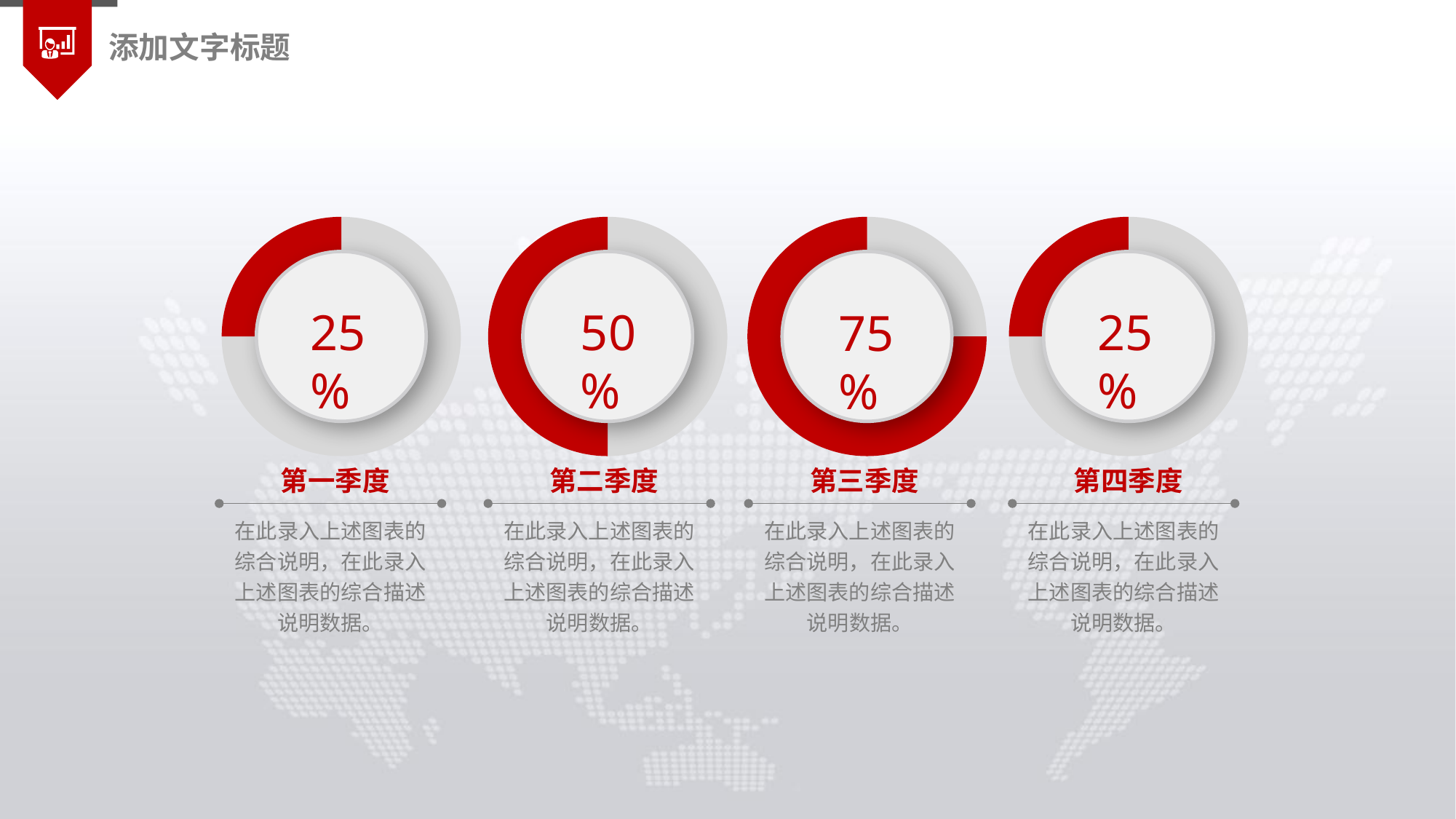
What is the difference between the 第二季度 value and the 第四季度 value? 25% What is the difference between the 第三季度 value and the 第一季度 value? 50% What value is shown in the 第三季度 ring chart? 75% What colour is the filled portion of each ring chart? Red Which quarter's ring chart shows the highest percentage? 第三季度 What kind of chart is used for each quarter on the slide? Ring (donut) chart Do the values rise or fall from 第一季度 to 第三季度? Rise What value is shown in the 第一季度 ring chart? 25% Which is larger, the 第二季度 value or the 第三季度 value? 第三季度 What value is shown in the 第二季度 ring chart? 50% How many ring charts are shown on the slide? 4 What value is shown in the 第四季度 ring chart? 25%